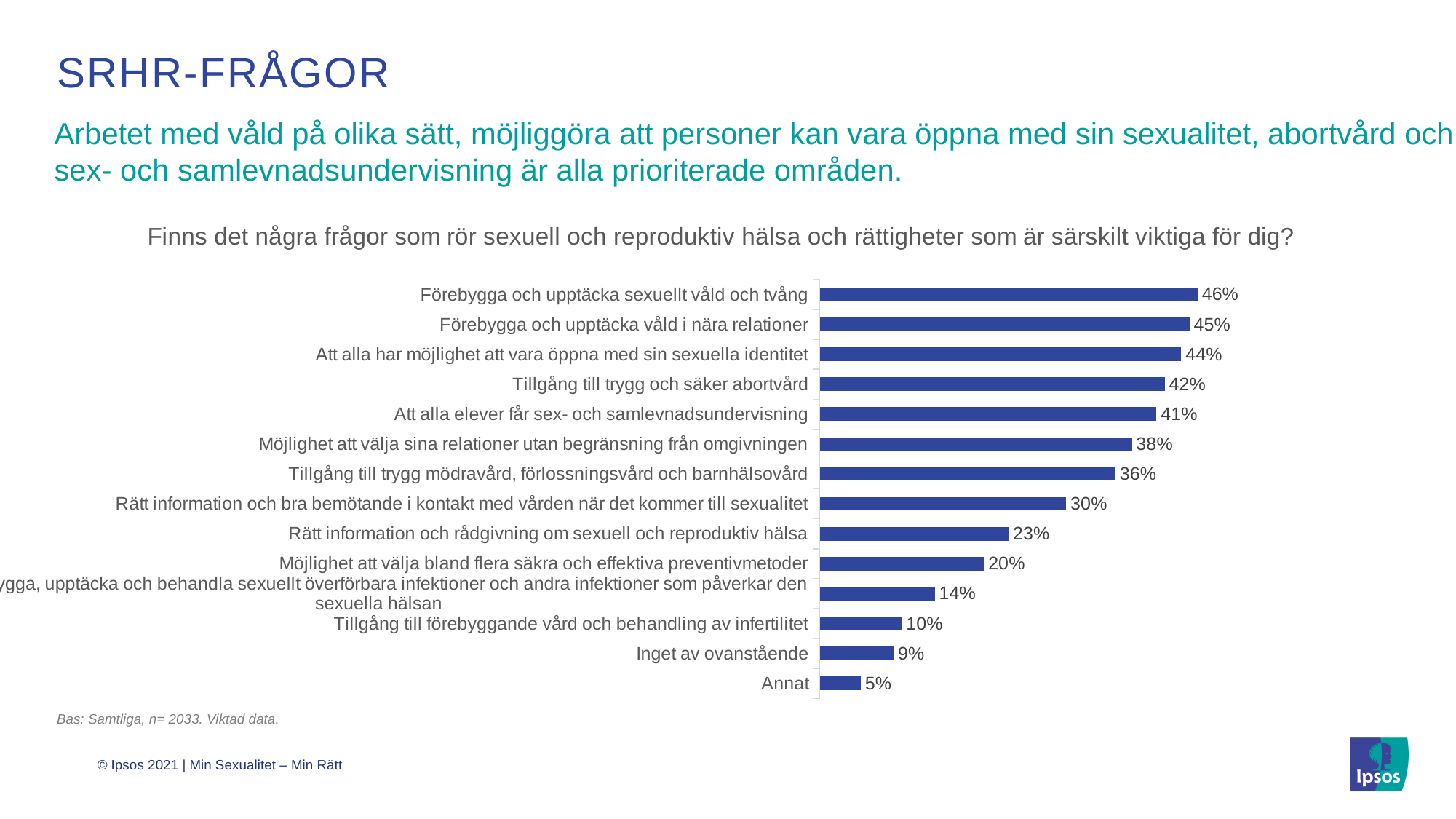
What is the value for "Möjlighet att välja sina relationer utan begränsning från omgivningen"? 38% What is the base (n) stated below the chart? n= 2033 What percentage of respondents chose "Förebygga och upptäcka sexuellt våld och tvång"? 46% Which category has the highest value in the chart? Förebygga och upptäcka sexuellt våld och tvång What is the difference between "Förebygga och upptäcka sexuellt våld och tvång" and "Förebygga och upptäcka våld i nära relationer"? 1 percentage point What is the difference between "Att alla elever får sex- och samlevnadsundervisning" and "Rätt information och rådgivning om sexuell och reproduktiv hälsa"? 18 percentage points What is the value for "Inget av ovanstående"? 9% What kind of chart is shown on the slide? Bar chart How many categories are shown in the bar chart? 14 Which is larger: the value for "Tillgång till trygg mödravård, förlossningsvård och barnhälsovård" or the value for "Möjlighet att välja bland flera säkra och effektiva preventivmetoder"? Tillgång till trygg mödravård, förlossningsvård och barnhälsovård What is the value for "Tillgång till trygg och säker abortvård"? 42% Which category has the lowest value in the chart? Annat